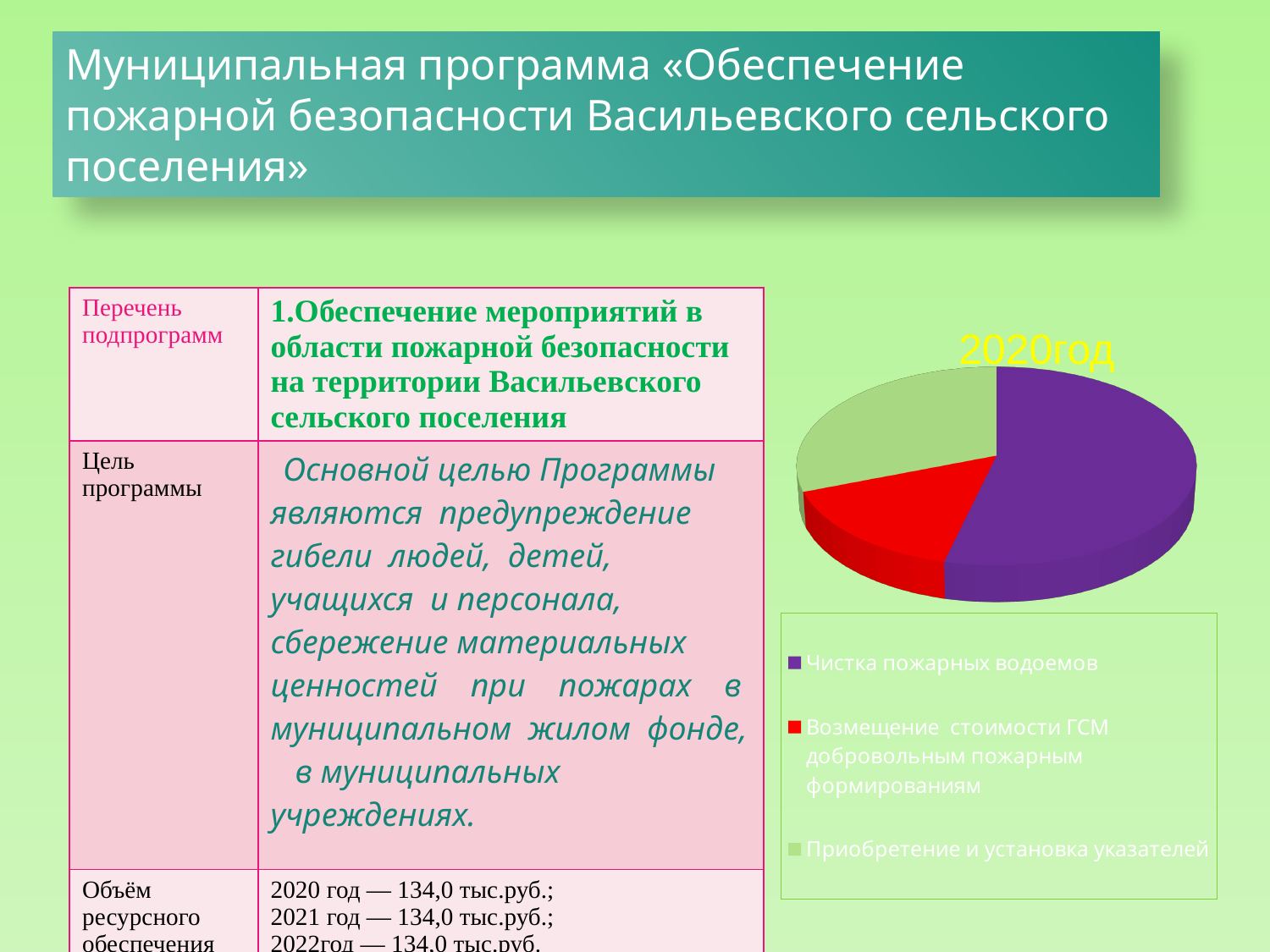
Which category has the largest slice in the pie chart? Чистка пожарных водоемов What is the title of the pie chart? 2020год Which slice is larger: Чистка пожарных водоемов or Приобретение и установка указателей? Чистка пожарных водоемов How many entries does the legend of the pie chart list? 3 What colour is the slice for Возмещение стоимости ГСМ добровольным пожарным формированиям? red Which slice is larger: Чистка пожарных водоемов or Возмещение стоимости ГСМ добровольным пожарным формированиям? Чистка пожарных водоемов What kind of chart is shown on the slide? pie chart How many slices does the pie chart have? 3